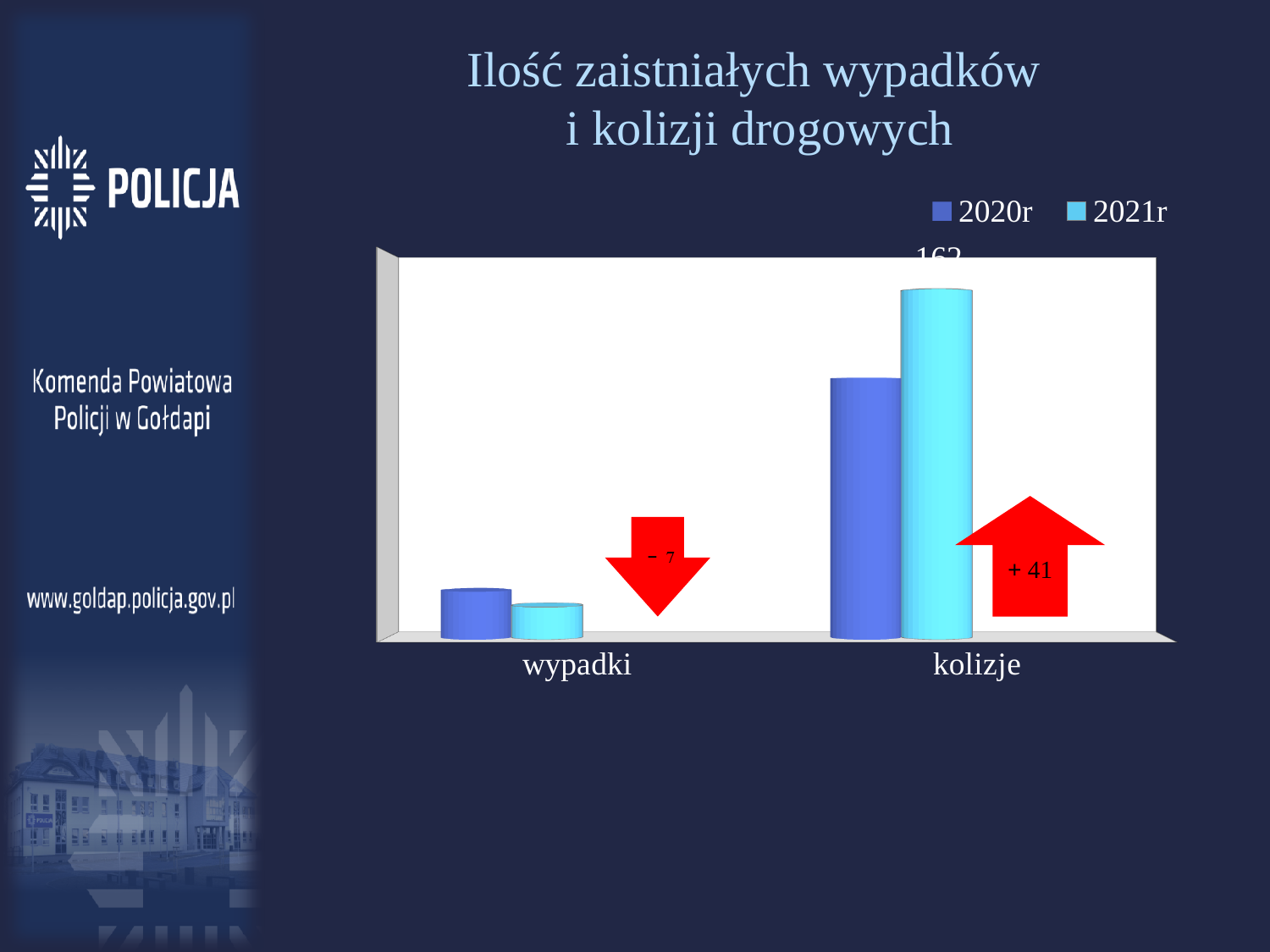
Which category has the highest bar in the chart? kolizje Which series are listed in the chart legend? 2020r and 2021r Which bar is the shortest in the chart? wypadki, 2021r Which bar is the tallest in the chart? kolizje, 2021r For wypadki, which year has the larger value, 2020r or 2021r? 2020r How many series does the chart legend list? 2 What kind of chart is shown on the slide? bar chart Is the 2021r bar for kolizje larger or smaller than the 2020r bar for wypadki? larger Which category has the lowest bars in the chart? wypadki How many categories are shown on the x axis of the chart? 2 What is the title of the chart? Ilość zaistniałych wypadków i kolizji drogowych For kolizje, which year has the larger value, 2020r or 2021r? 2021r